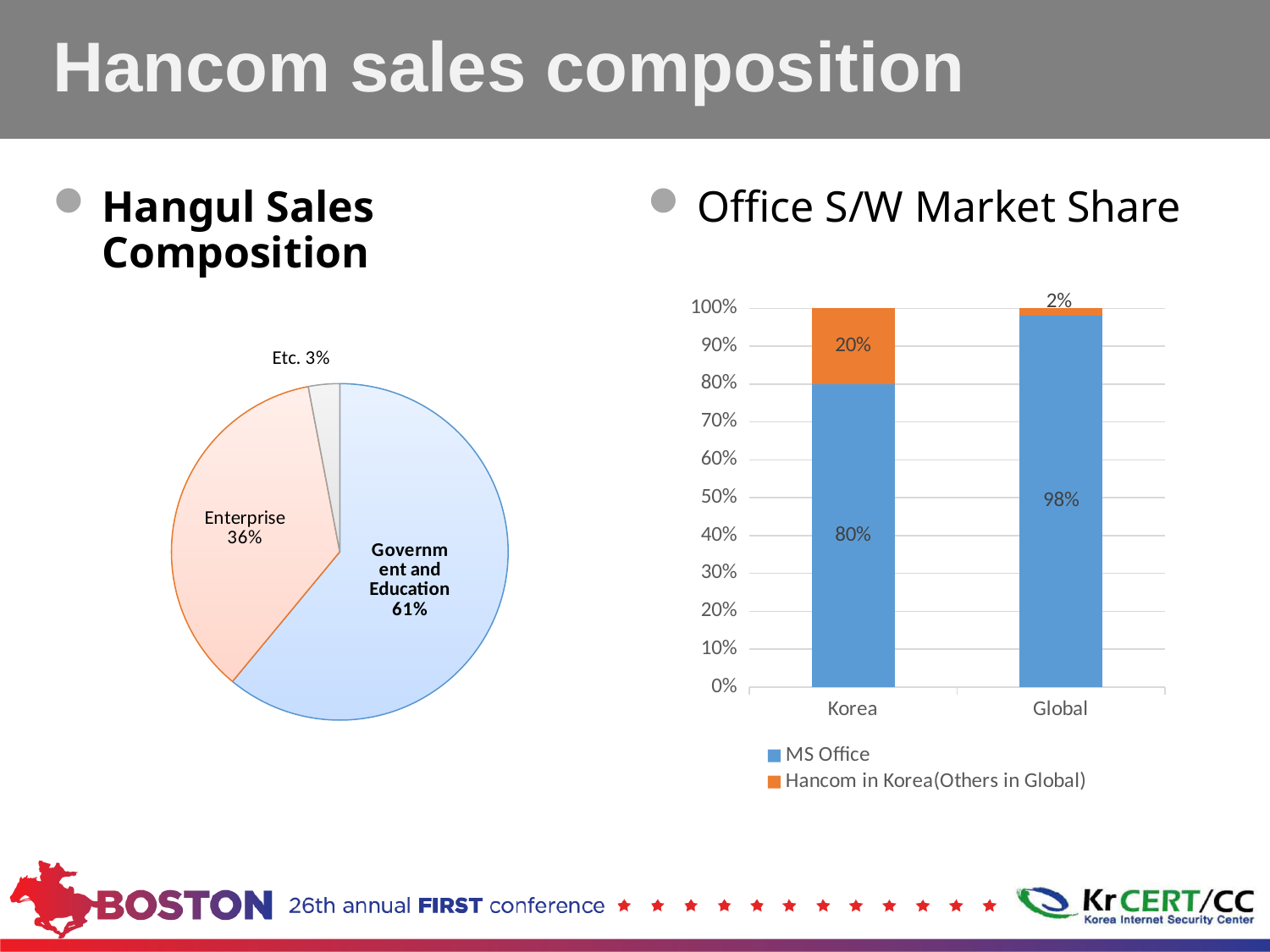
In the Office S/W Market Share chart, what is the difference between the MS Office value for Global and for Korea? 18% In the Hangul Sales Composition pie chart, which slice is the largest? Government and Education In the Hangul Sales Composition pie chart, what share does Government and Education have? 61% In the Hangul Sales Composition pie chart, what share does Enterprise have? 36% In the Office S/W Market Share chart, which series is shown in orange? Hancom in Korea(Others in Global) In the Office S/W Market Share chart, what is the value of the orange segment for Global? 2% In the Hangul Sales Composition pie chart, how many slices are there? 3 In the Office S/W Market Share chart, how many series does the legend list? 2 In the Hangul Sales Composition pie chart, what is the difference between the Government and Education share and the Enterprise share? 25% In the Office S/W Market Share chart, what is the MS Office value for Korea? 80% In the Hangul Sales Composition pie chart, which slice is the smallest? Etc. What kind of chart is the Office S/W Market Share chart? Stacked bar chart